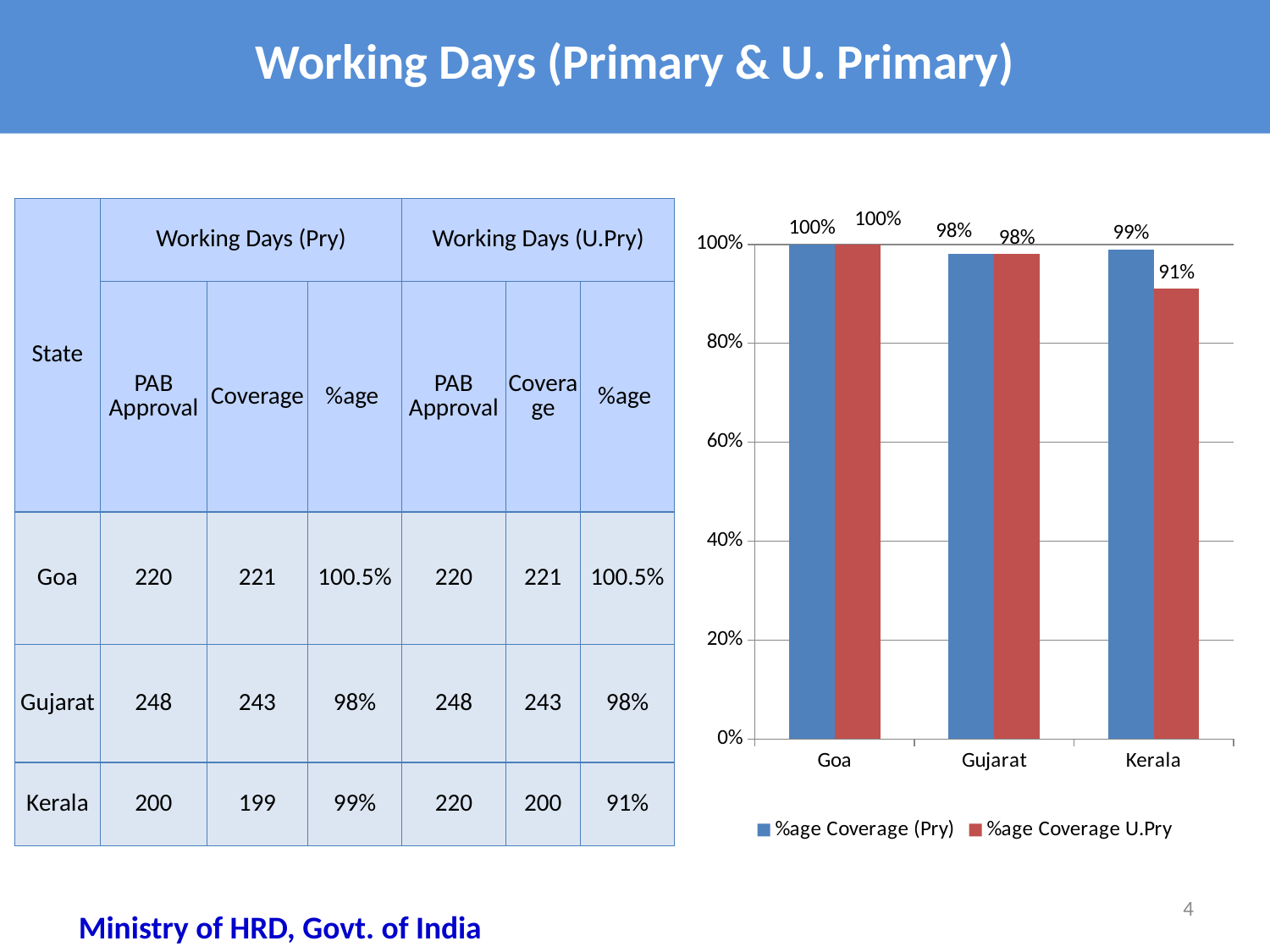
What are the two series names listed in the chart legend? %age Coverage (Pry) and %age Coverage U.Pry Which state has the highest %age Coverage (Pry) value in the chart? Goa What is the %age Coverage (Pry) value for Kerala in the chart? 99% What is the %age Coverage U.Pry value for Goa in the chart? 100% What type of chart is shown on the slide? bar chart What is the difference between the %age Coverage (Pry) and %age Coverage U.Pry values for Kerala in the chart? 8% For Kerala, which is larger in the chart: %age Coverage (Pry) or %age Coverage U.Pry? %age Coverage (Pry) How many series does the chart legend list? 2 Which state has the lowest %age Coverage U.Pry value in the chart? Kerala What is the %age Coverage U.Pry value for Kerala in the chart? 91% How many states are shown on the x axis of the chart? 3 What is the %age Coverage (Pry) value for Gujarat in the chart? 98%